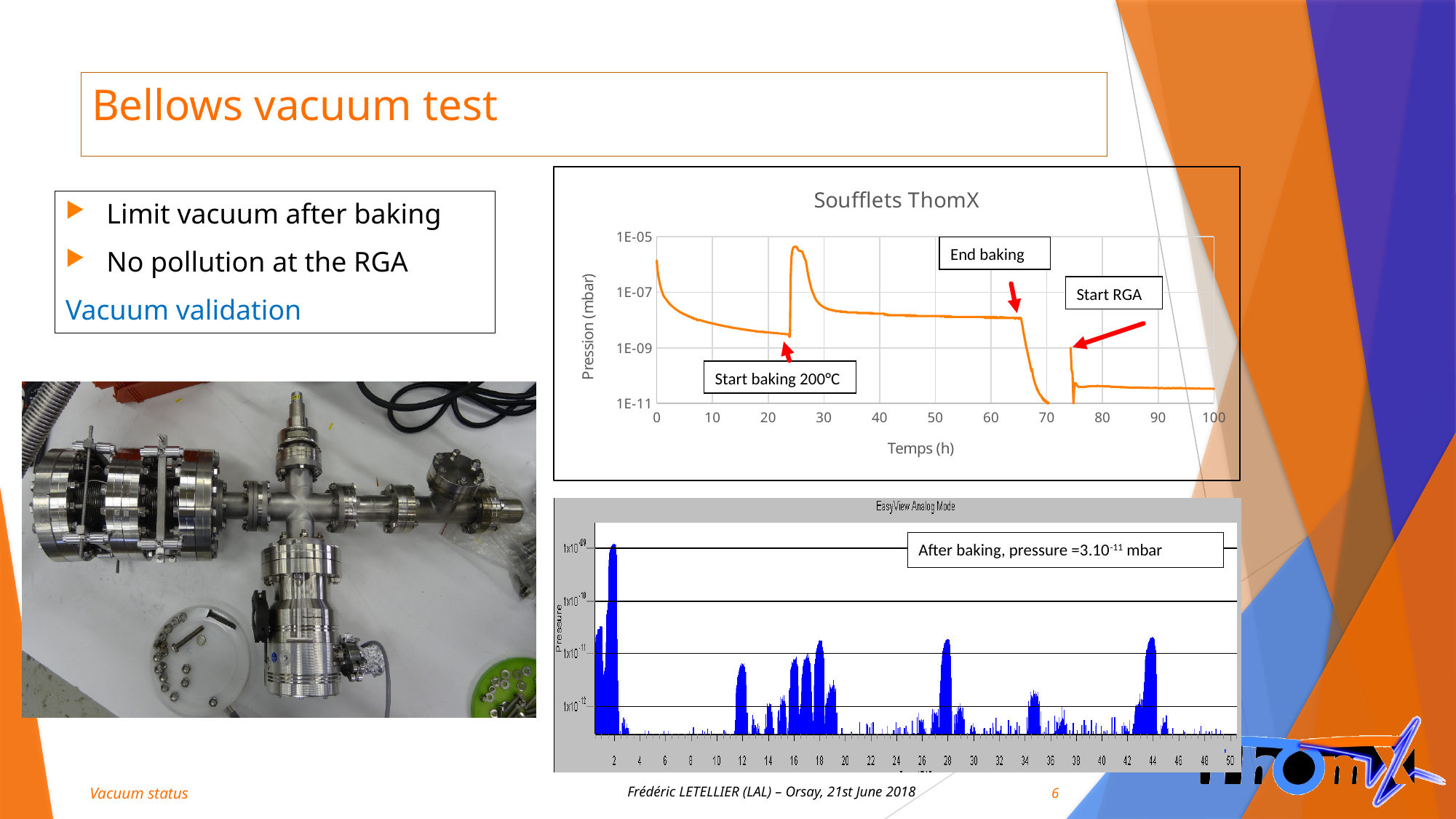
According to the annotation on the bottom RGA chart, what is the pressure after baking? 3.10⁻¹¹ mbar In the Soufflets ThomX chart, is the pressure at 50 h greater or less than 1E-07 mbar? less In the Soufflets ThomX chart, is the pressure at time 0 h greater or less than 1E-07 mbar? greater In the bottom RGA chart, is the peak at mass 2 greater or less than 1x10⁻¹⁰? greater In the Soufflets ThomX chart, does the pressure rise or fall between 0 h and 20 h? fall In the Soufflets ThomX chart, what is the largest value shown on the Temps (h) axis? 100 In the bottom RGA chart (EasyView Analog Mode), at which mass number is the highest peak? 2 In the Soufflets ThomX chart, does the pressure rise or fall between 65 h and 70 h? fall What is the title of the top chart? Soufflets ThomX What kind of chart is the top chart, Soufflets ThomX? line chart In the Soufflets ThomX chart, which is higher: the pressure at 10 h or the pressure at 90 h? 10 h